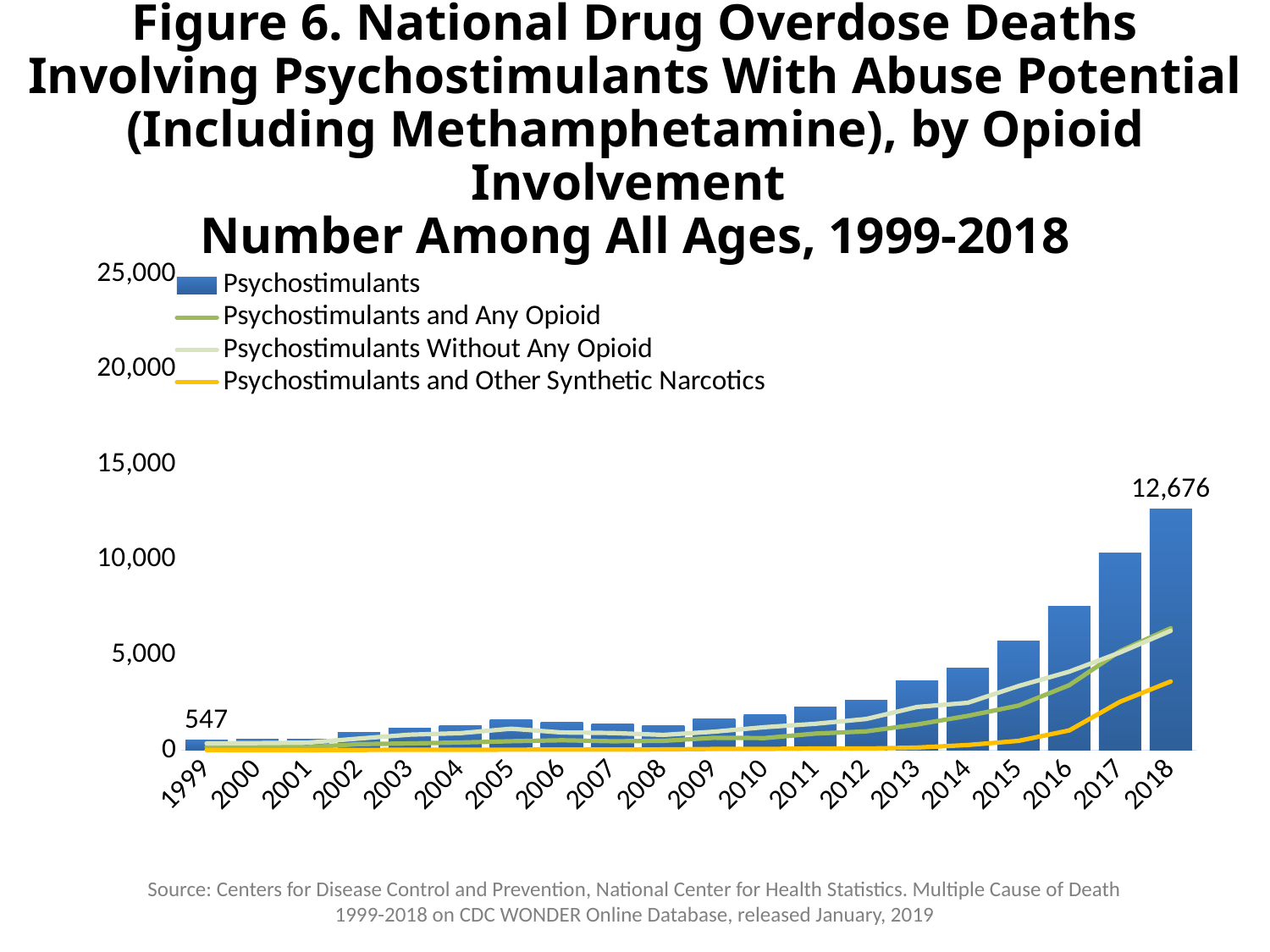
What is the number of psychostimulant overdose deaths shown for 1999? 547 By how much did the Psychostimulants value increase from 1999 to 2018? 12,129 How many years are shown on the x axis? 20 How many series does the legend list? 4 Is the Psychostimulants value for 2014 greater or less than 5,000? less What is the number of psychostimulant overdose deaths shown for 2018? 12,676 Which series is plotted as bars rather than a line? Psychostimulants What kind of chart is this? Bar chart with line series Do the Psychostimulants bars rise or fall from 1999 to 2018? Rise Which year has the highest Psychostimulants bar? 2018 Is the Psychostimulants value for 2016 greater or less than 5,000? greater In 2018, which is larger: Psychostimulants Without Any Opioid or Psychostimulants and Other Synthetic Narcotics? Psychostimulants Without Any Opioid